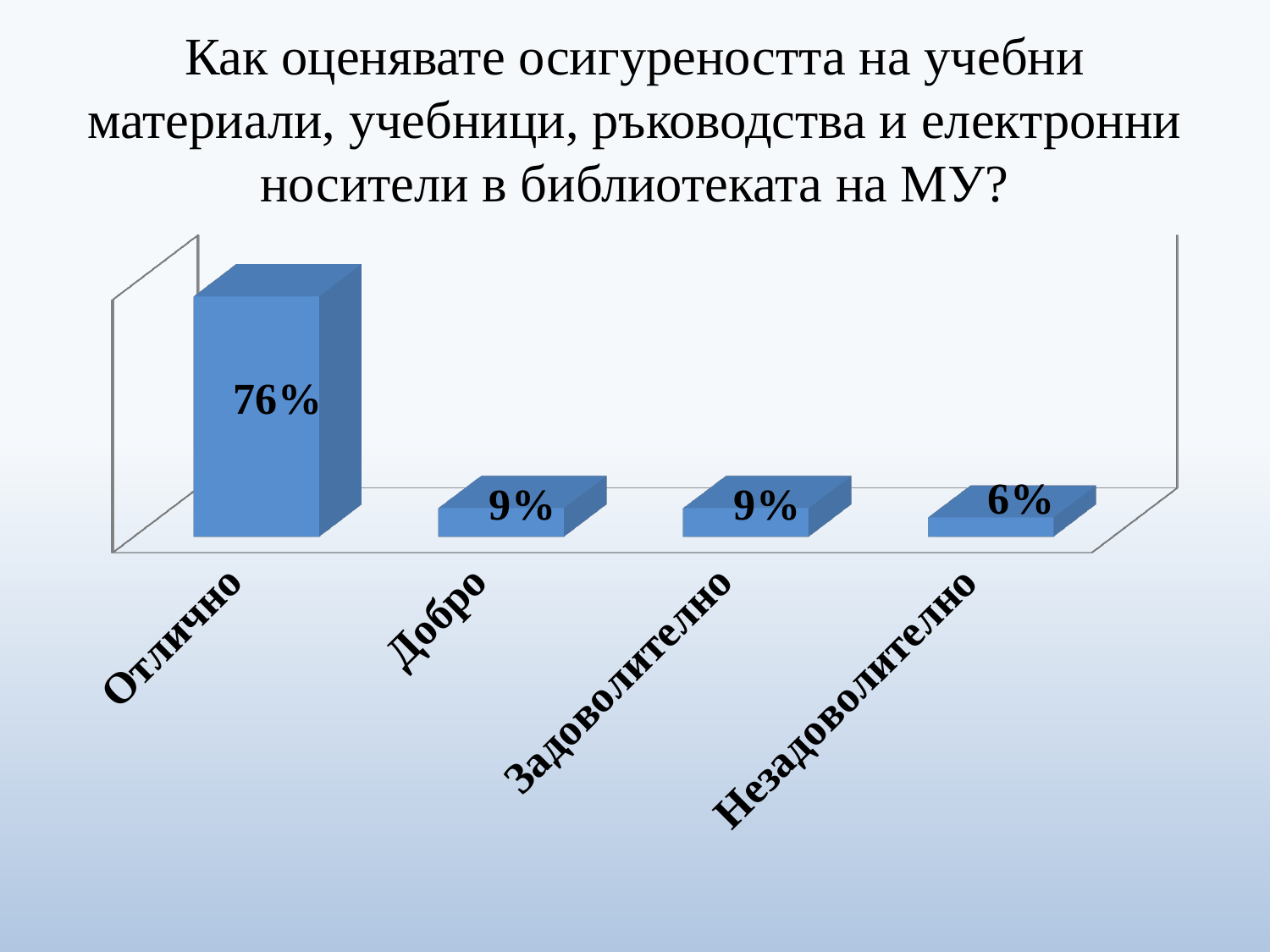
Which category has the lowest value? Незадоволително What is the value for Добро? 9% Do the values rise or fall from left to right across the categories? Fall What is the value for Незадоволително? 6% What is the value for Задоволително? 9% What is the difference between the values for Отлично and Добро? 67% What kind of chart is shown on the slide? Bar chart What is the value for Отлично? 76% Which is larger, the value for Добро or the value for Незадоволително? Добро Which category has the highest value? Отлично How many categories are shown in the chart? 4 What is the difference between the values for Задоволително and Незадоволително? 3%